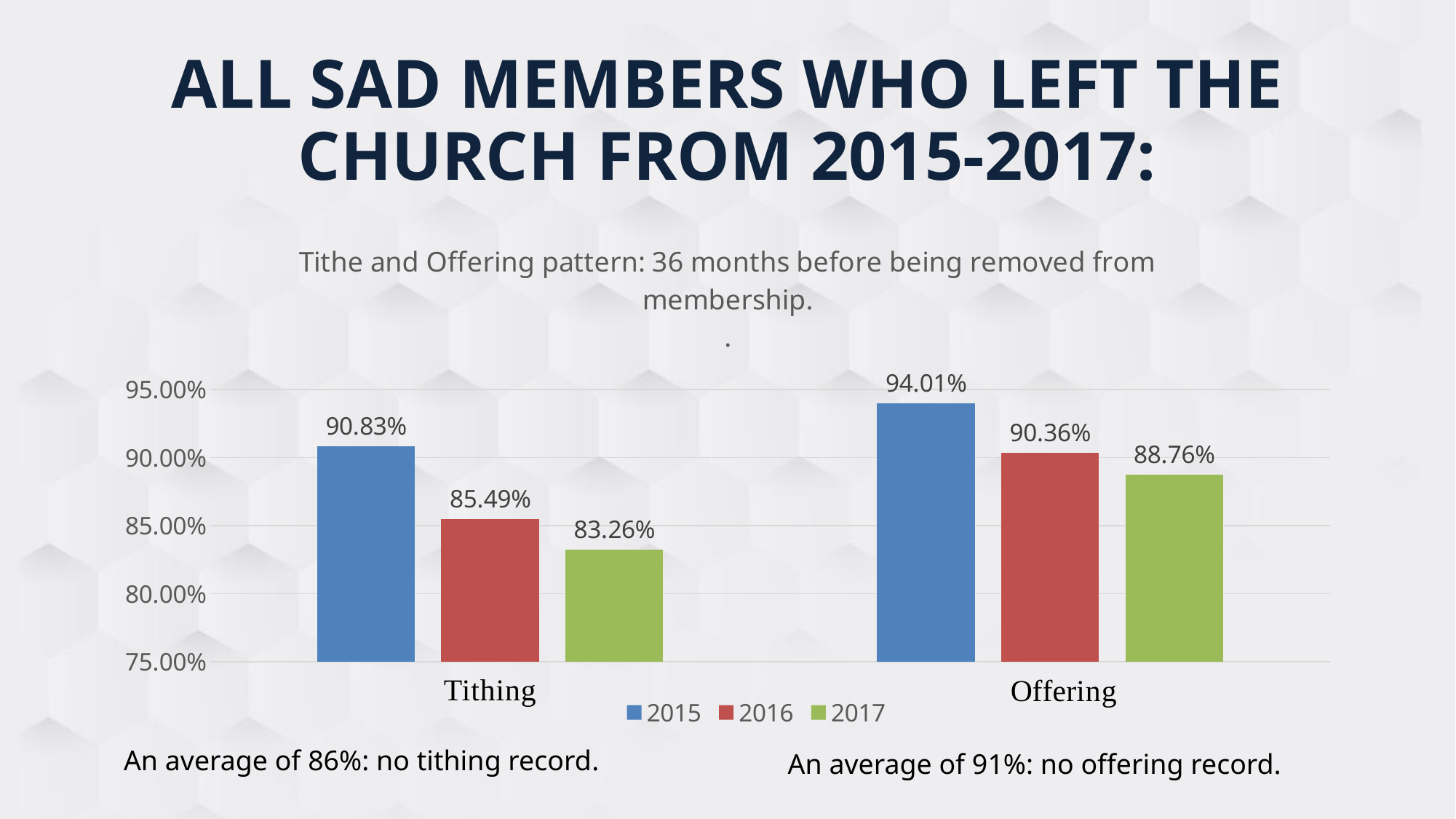
What is the value for 2017 in the Offering category? 88.76% What is the value for 2015 in the Tithing category? 90.83% How many series does the legend list? 3 Is the 2017 value for Tithing greater or less than 85.00%? less Do the values from 2015 to 2017 rise or fall within the Offering category? fall Which year has the lowest value in the Tithing category? 2017 How many categories are shown on the x axis? 2 What kind of chart is shown on the slide? bar chart What is the value for 2016 in the Offering category? 90.36% What is the difference between the 2015 and 2017 values in the Tithing category? 7.57% Which is larger: the 2016 value for Tithing or the 2016 value for Offering? Offering Which year has the highest value in the Offering category? 2015